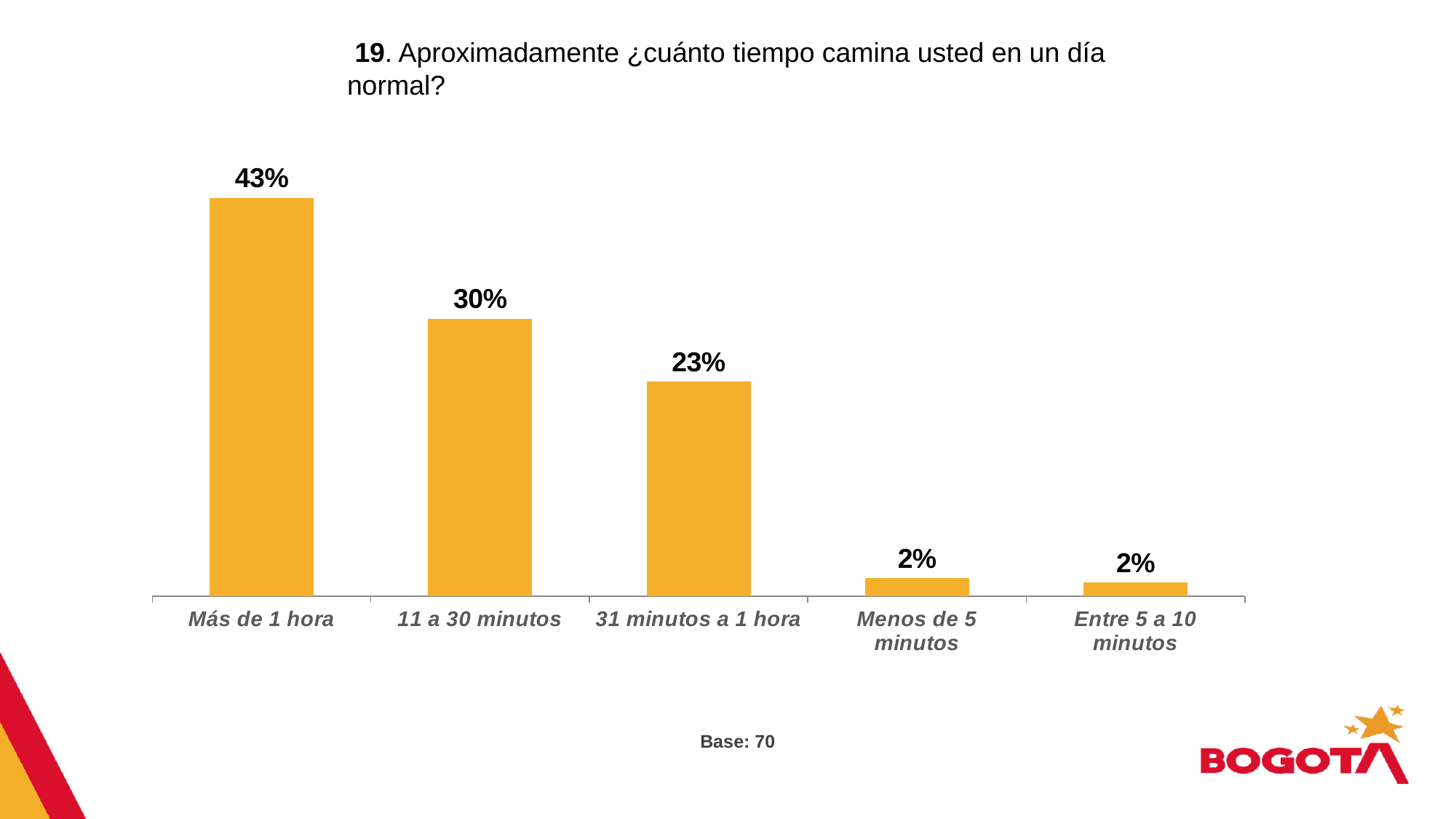
Which category has the highest value? Más de 1 hora How many categories are shown in the chart? 5 What kind of chart is shown on the slide? Bar chart What is the value shown for '31 minutos a 1 hora'? 23% What is the difference between the values for 'Más de 1 hora' and '11 a 30 minutos'? 13% Do the values rise or fall from left to right across the categories? Fall What is the value shown for '11 a 30 minutos'? 30% What is the base (number of respondents) stated below the chart? 70 What is the value shown for 'Menos de 5 minutos'? 2% What is the difference between the values for '11 a 30 minutos' and '31 minutos a 1 hora'? 7% Which is larger, the value for '11 a 30 minutos' or the value for '31 minutos a 1 hora'? 11 a 30 minutos What percentage of respondents walk 'Más de 1 hora' on a normal day? 43%